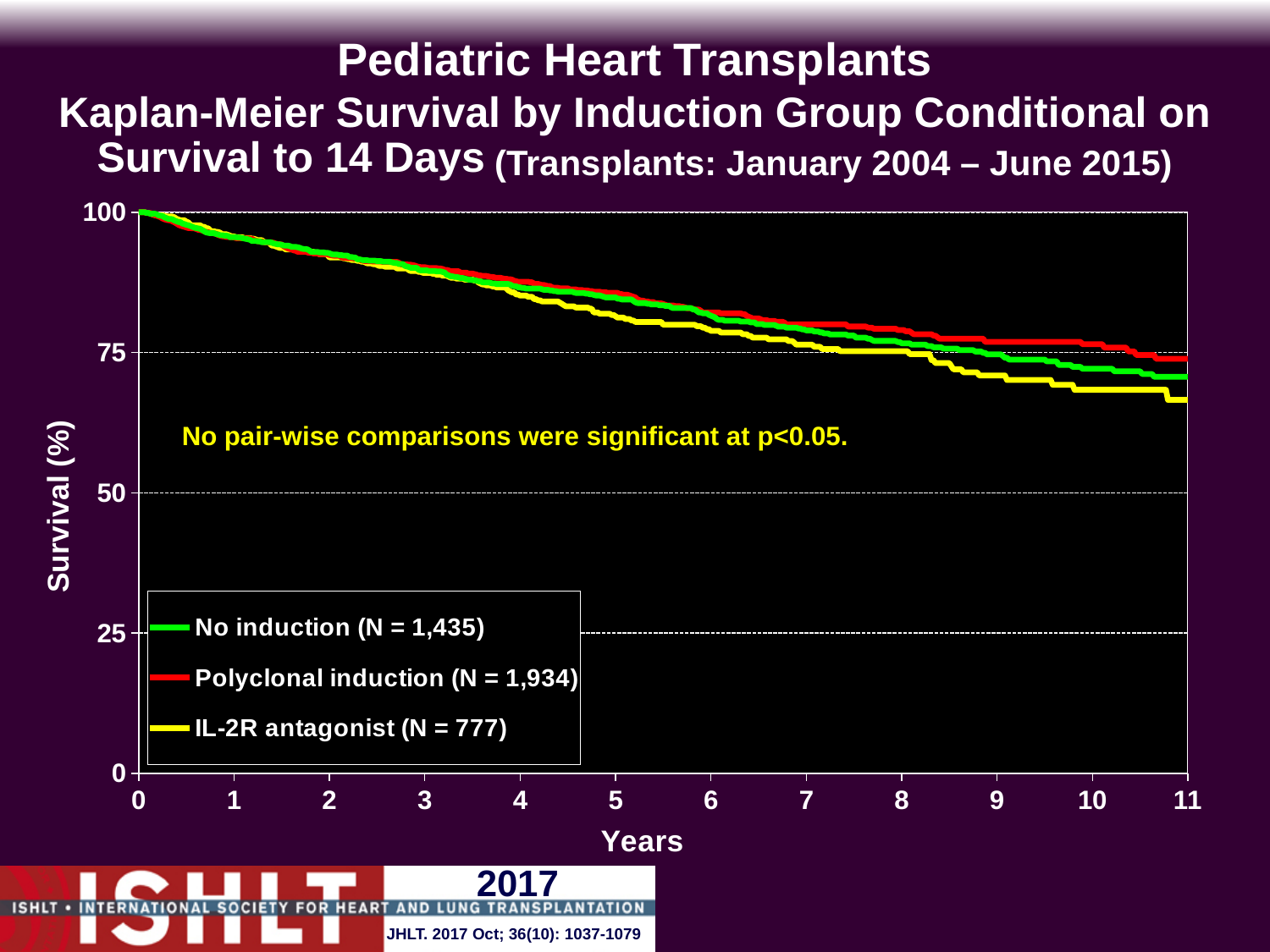
What is the N for the Polyclonal induction group shown in the legend? 1,934 Do the survival curves rise or fall as years increase? fall Which induction group has the highest survival at year 11? Polyclonal induction At year 10, is survival higher for Polyclonal induction or IL-2R antagonist? Polyclonal induction Which induction group has the lowest survival at year 11? IL-2R antagonist Is the survival value for IL-2R antagonist at year 11 greater or less than 75? less What is the survival value for all groups at year 0? 100 What is the N for the No induction group shown in the legend? 1,435 What is the label of the y axis? Survival (%) Is the survival value for No induction at year 5 greater or less than 75? greater What kind of chart is shown on the slide? line chart How many series does the legend list? 3